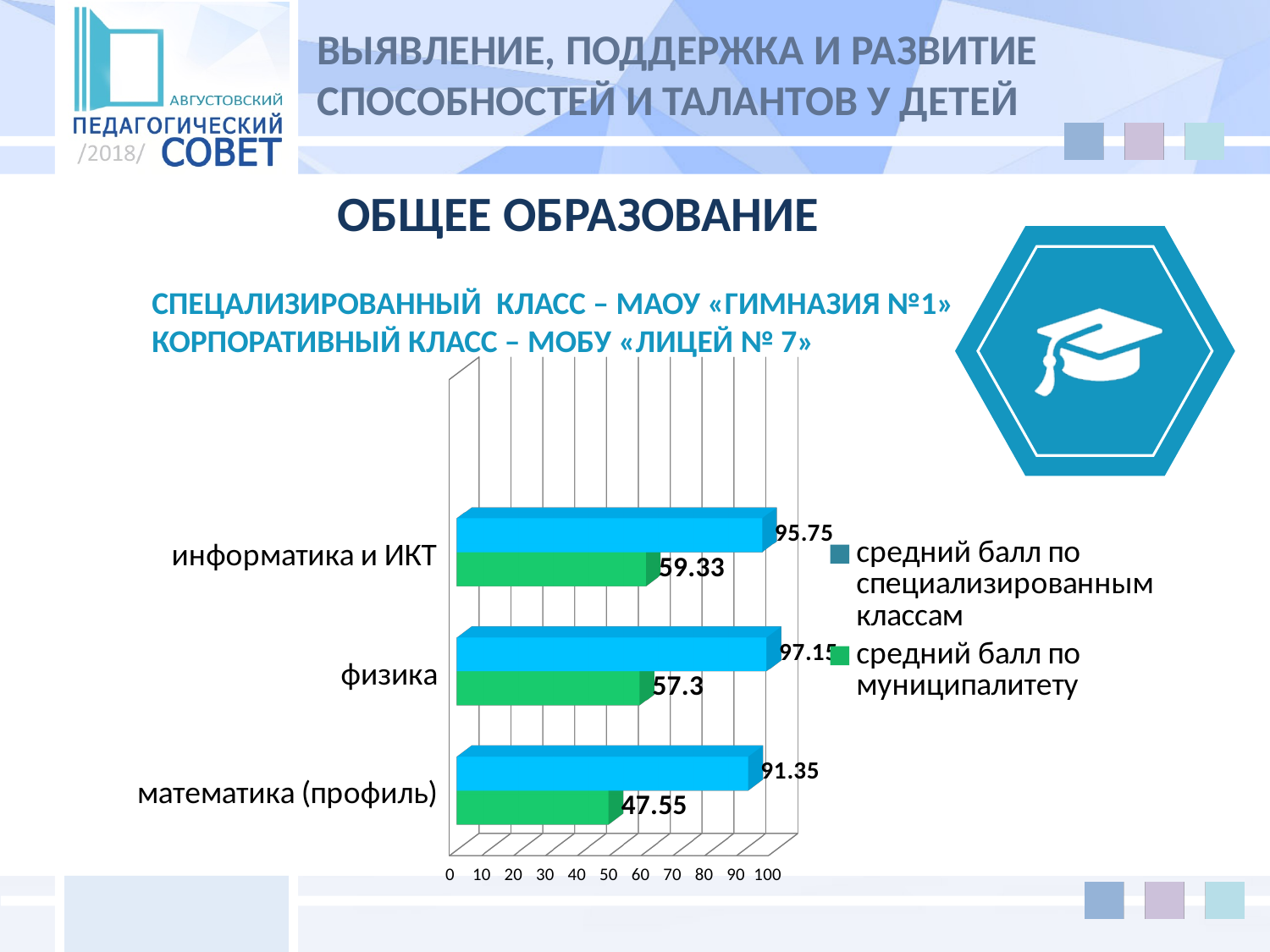
How many subjects are shown on the chart? 3 Is the specialized-class score in математика (профиль) greater or less than 90? greater Which subject has the lowest average score for the municipality? математика (профиль) What is the average score for the municipality (средний балл по муниципалитету) in математика (профиль)? 47.55 What type of chart is shown on the slide? bar chart How many series does the legend list? 2 What colour are the bars for средний балл по муниципалитету? green Which is larger: the municipality score in информатика и ИКТ or the municipality score in физика? информатика и ИКТ Which subject has the highest average score for specialized classes? физика What is the average score for specialized classes (средний балл по специализированным классам) in физика? 97.15 What is the average score for the municipality in информатика и ИКТ? 59.33 What is the difference between the specialized-class score and the municipality score in математика (профиль)? 43.8